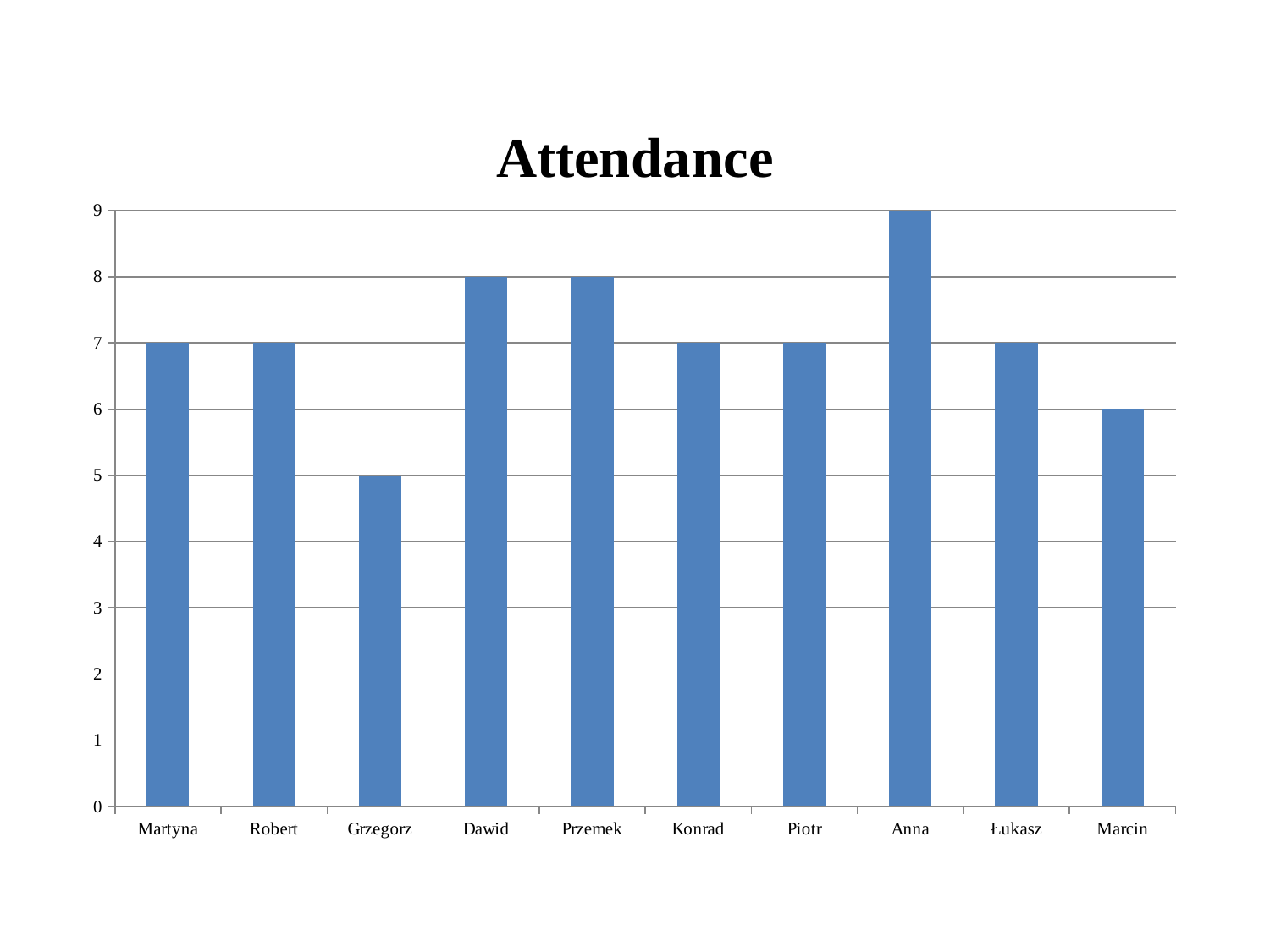
What is the title of the chart? Attendance Who has the higher attendance, Przemek or Piotr? Przemek Which person has the highest attendance? Anna What is the attendance value for Marcin? 6 What is the attendance value for Grzegorz? 5 Which person has the lowest attendance? Grzegorz How many people are shown on the x axis? 10 What is the difference between Dawid's and Marcin's attendance? 2 What is the difference between Anna's and Grzegorz's attendance? 4 What kind of chart is shown on the slide? bar chart Is the value for Grzegorz greater or less than 6? less What is the attendance value for Anna? 9